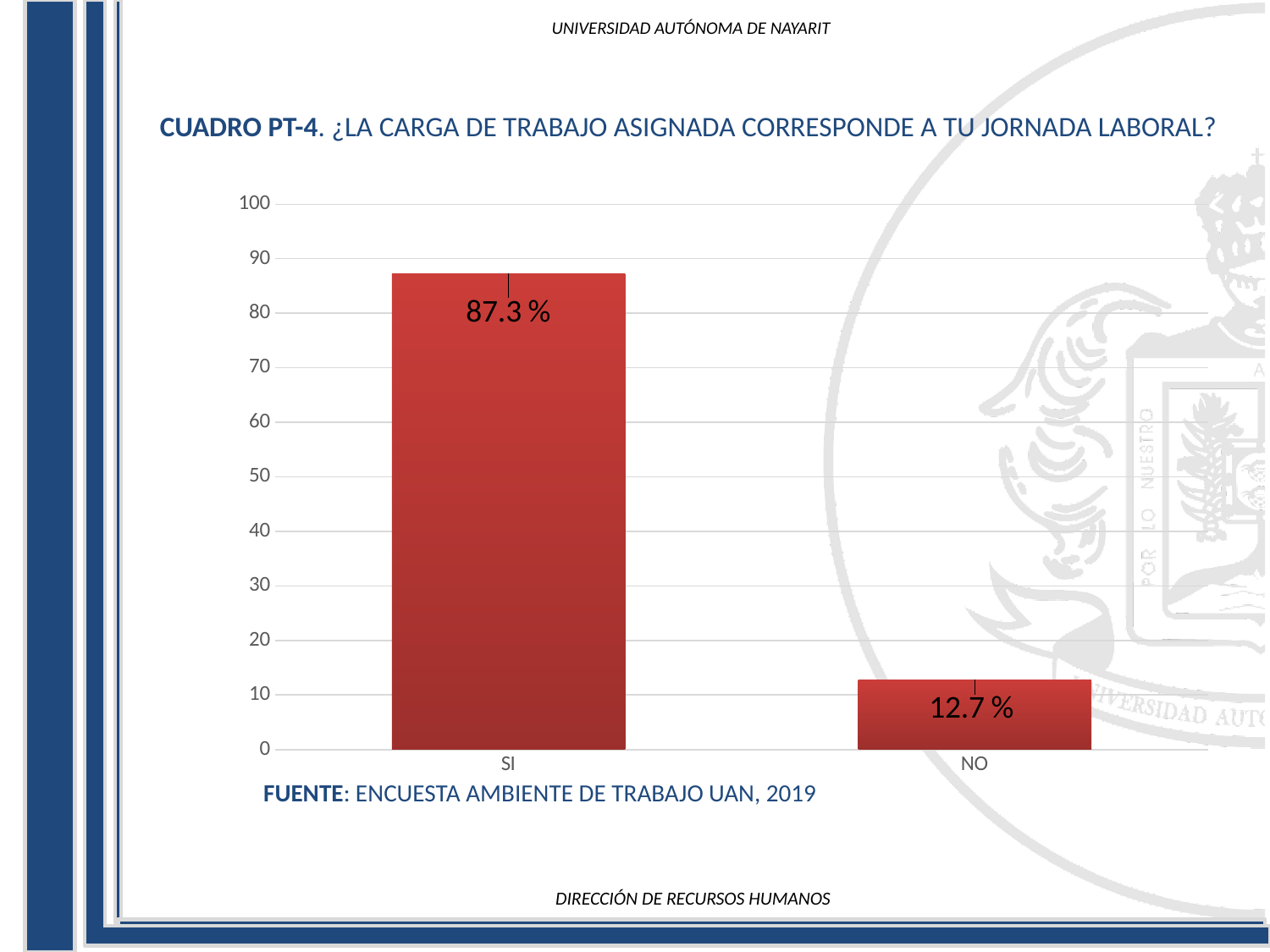
Which category has the lowest value? NO What kind of chart is shown on the slide? bar chart What is the value for NO? 12.7 % What is the source cited below the chart? ENCUESTA AMBIENTE DE TRABAJO UAN, 2019 What is the difference between the values for SI and NO? 74.6 % Which is larger, the value for SI or the value for NO? SI What is the highest value shown on the y axis? 100 Is the value for SI greater or less than 80? greater What is the value for SI? 87.3 % Is the value for NO greater or less than 20? less How many categories are shown on the x axis? 2 Which category has the highest value? SI